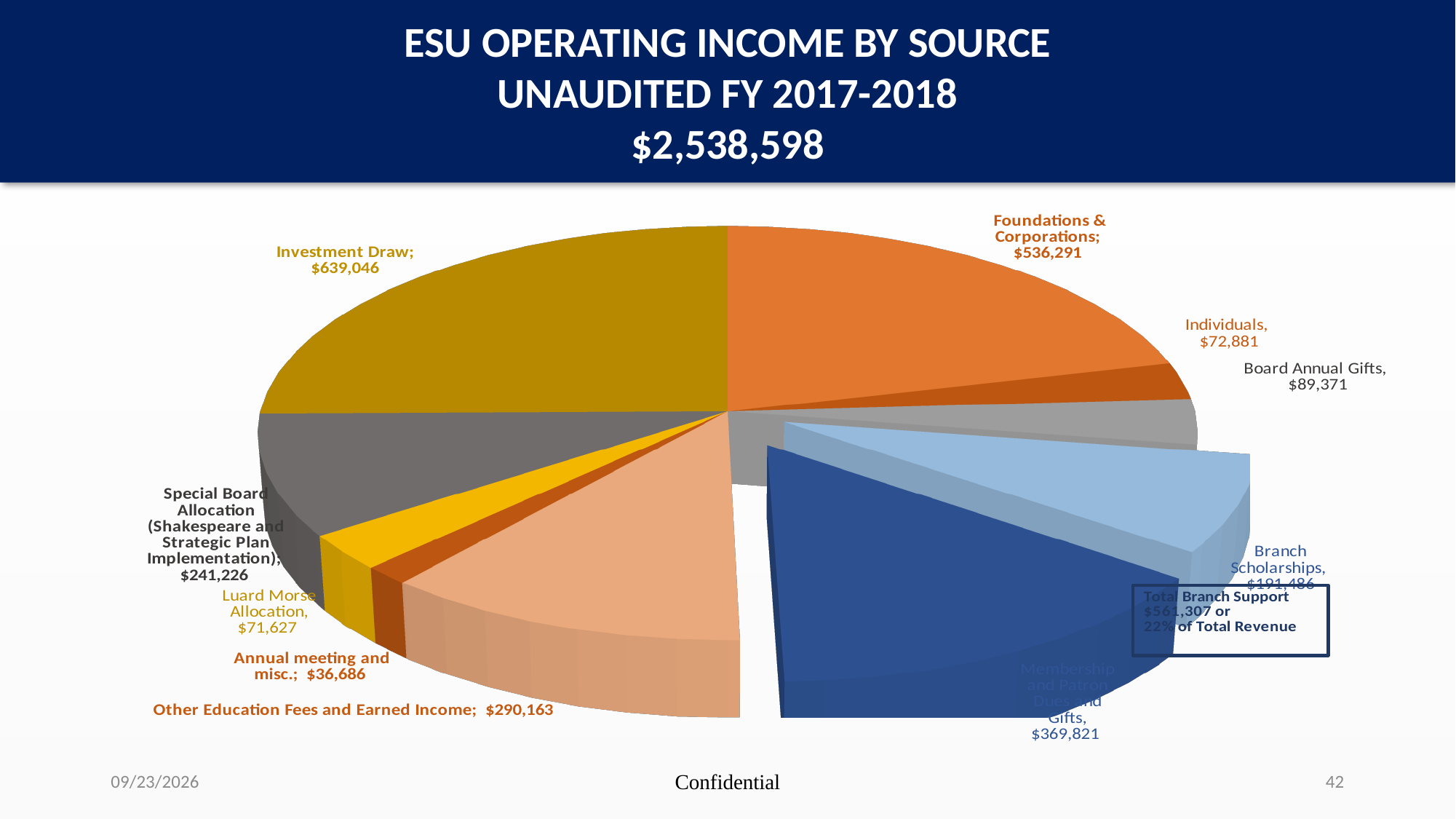
Which income source has the smallest slice? Annual meeting and misc. Which income source has the largest slice? Investment Draw What is the value for Luard Morse Allocation? $71,627 What is the value for Investment Draw? $639,046 What is the difference between Investment Draw and Foundations & Corporations? $102,755 Which is larger: Membership and Patron Dues and Gifts or Other Education Fees and Earned Income? Membership and Patron Dues and Gifts What is the difference between Board Annual Gifts and Individuals? $16,490 What kind of chart is shown on the slide? pie chart What is the value for Foundations & Corporations? $536,291 According to the text box, what percentage of total revenue is Total Branch Support? 22% What is the value for Board Annual Gifts? $89,371 How many income sources are shown in the pie chart? 10